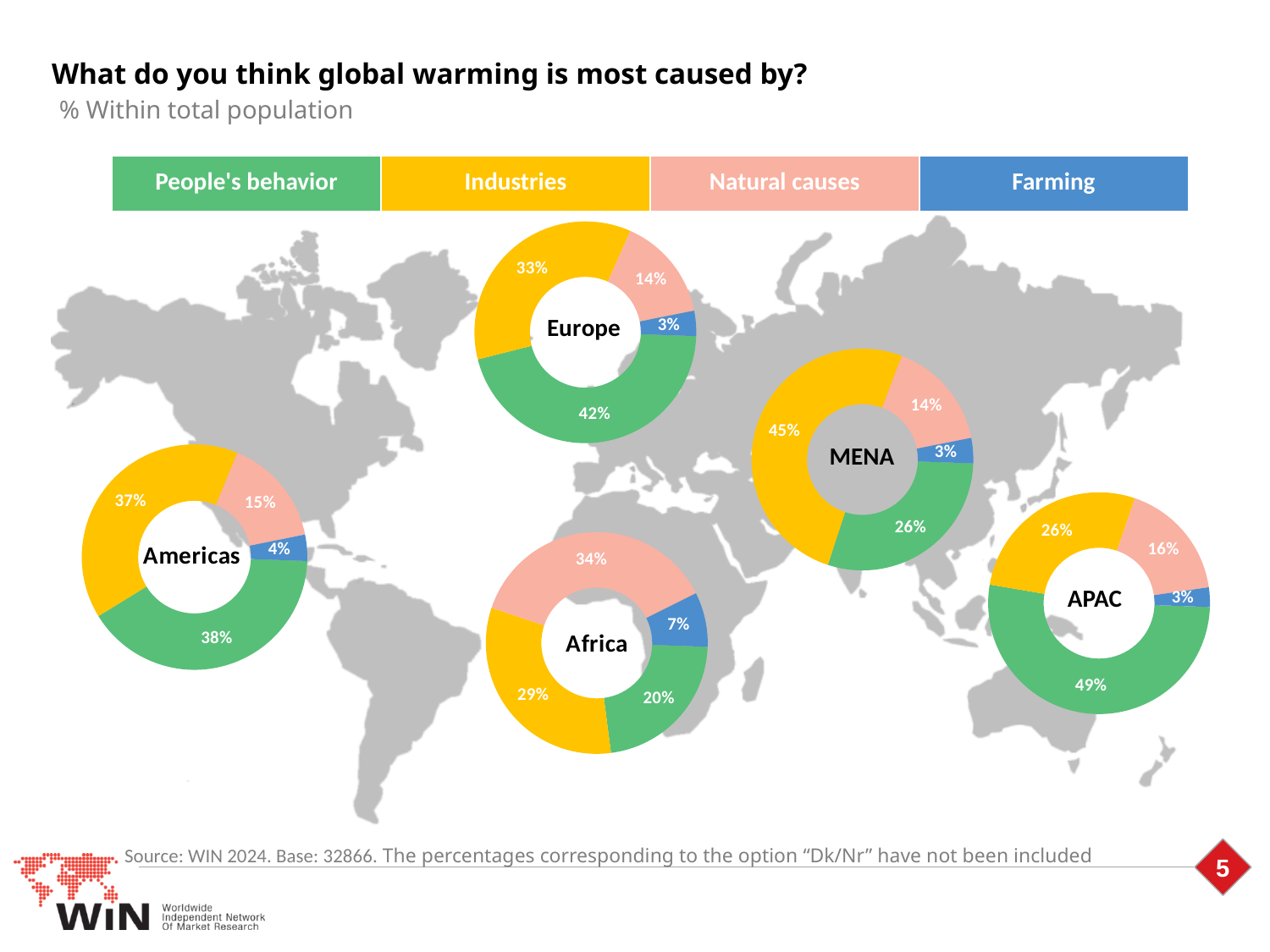
In the Americas chart, which cause has the smallest share? Farming In the APAC chart, what percentage is shown for Farming? 3% In the Africa chart, what percentage is shown for Natural causes? 34% In the MENA chart, what percentage is shown for Industries? 45% Which colour represents Natural causes in the legend? Pink In the Africa chart, what is the difference between the Natural causes share and the People's behavior share? 14% In the MENA chart, which is larger: the share for Industries or the share for People's behavior? Industries What type of chart is used for each region on the slide? Donut chart How many categories does the legend at the top of the slide list? 4 How many donut charts are shown on the slide? 5 In the Europe chart, what percentage is shown for People's behavior? 42% In the APAC chart, which cause has the largest share? People's behavior